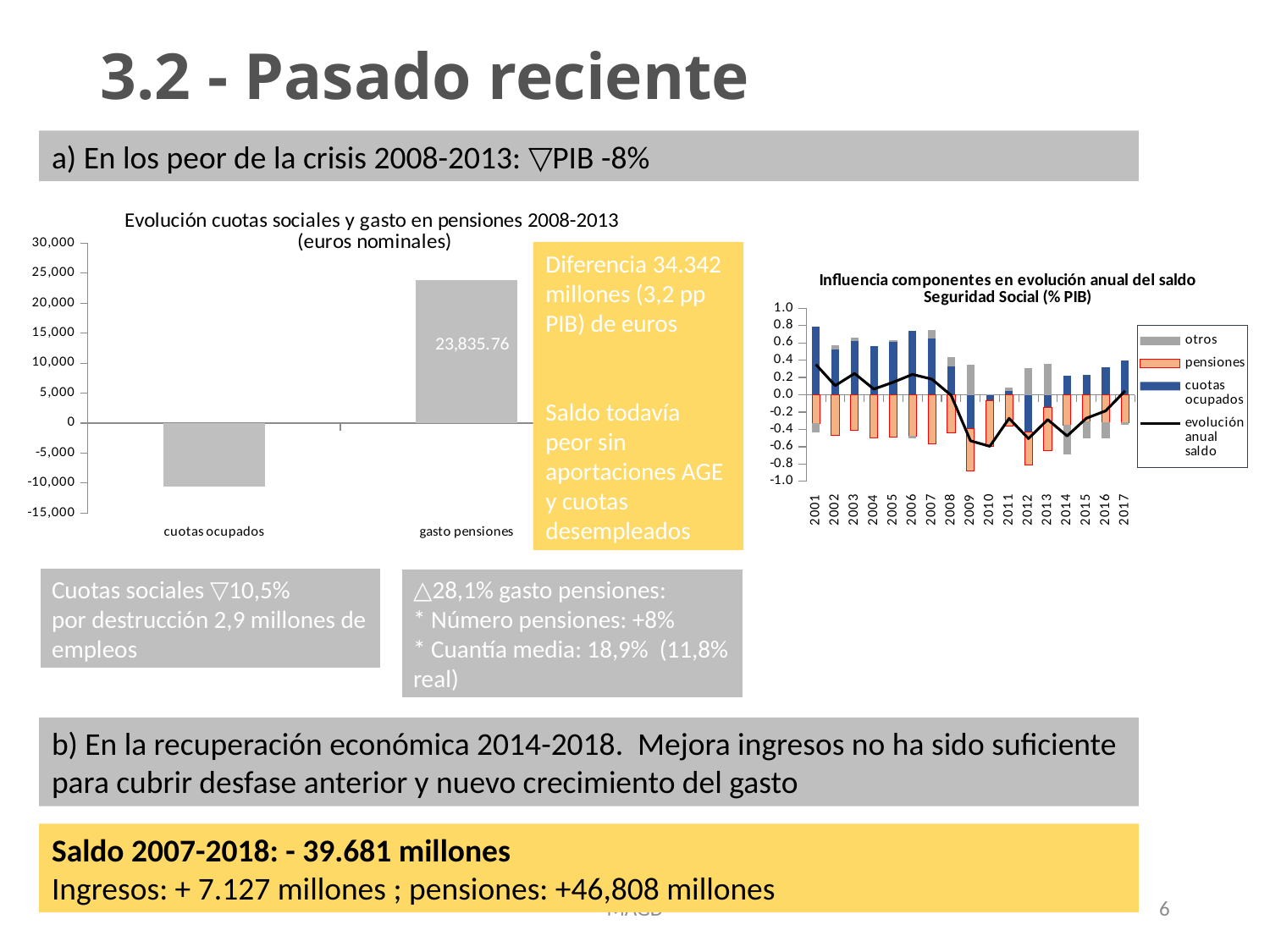
What are the legend entries in the chart 'Influencia componentes en evolución anual del saldo Seguridad Social (% PIB)'? otros, pensiones, cuotas ocupados, evolución anual saldo How many categories are plotted in the chart 'Evolución cuotas sociales y gasto en pensiones 2008-2013'? 2 In the chart 'Evolución cuotas sociales y gasto en pensiones 2008-2013', which category has the higher value, cuotas ocupados or gasto pensiones? gasto pensiones How many years are shown on the x axis of the chart 'Influencia componentes en evolución anual del saldo Seguridad Social (% PIB)'? 17 How many series does the legend list in the chart 'Influencia componentes en evolución anual del saldo Seguridad Social (% PIB)'? 4 In the chart 'Influencia componentes en evolución anual del saldo Seguridad Social (% PIB)', is the evolución anual saldo line value for 2009 greater or less than 0.0? less In the chart 'Influencia componentes en evolución anual del saldo Seguridad Social (% PIB)', is the cuotas ocupados value for 2001 greater or less than 0.5? greater In the chart 'Evolución cuotas sociales y gasto en pensiones 2008-2013', which category has the lowest value? cuotas ocupados In the chart 'Evolución cuotas sociales y gasto en pensiones 2008-2013', what is the value shown for gasto pensiones? 23,835.76 In the chart 'Evolución cuotas sociales y gasto en pensiones 2008-2013', is the value for cuotas ocupados greater or less than -5,000? less What kind of chart is 'Evolución cuotas sociales y gasto en pensiones 2008-2013'? bar chart